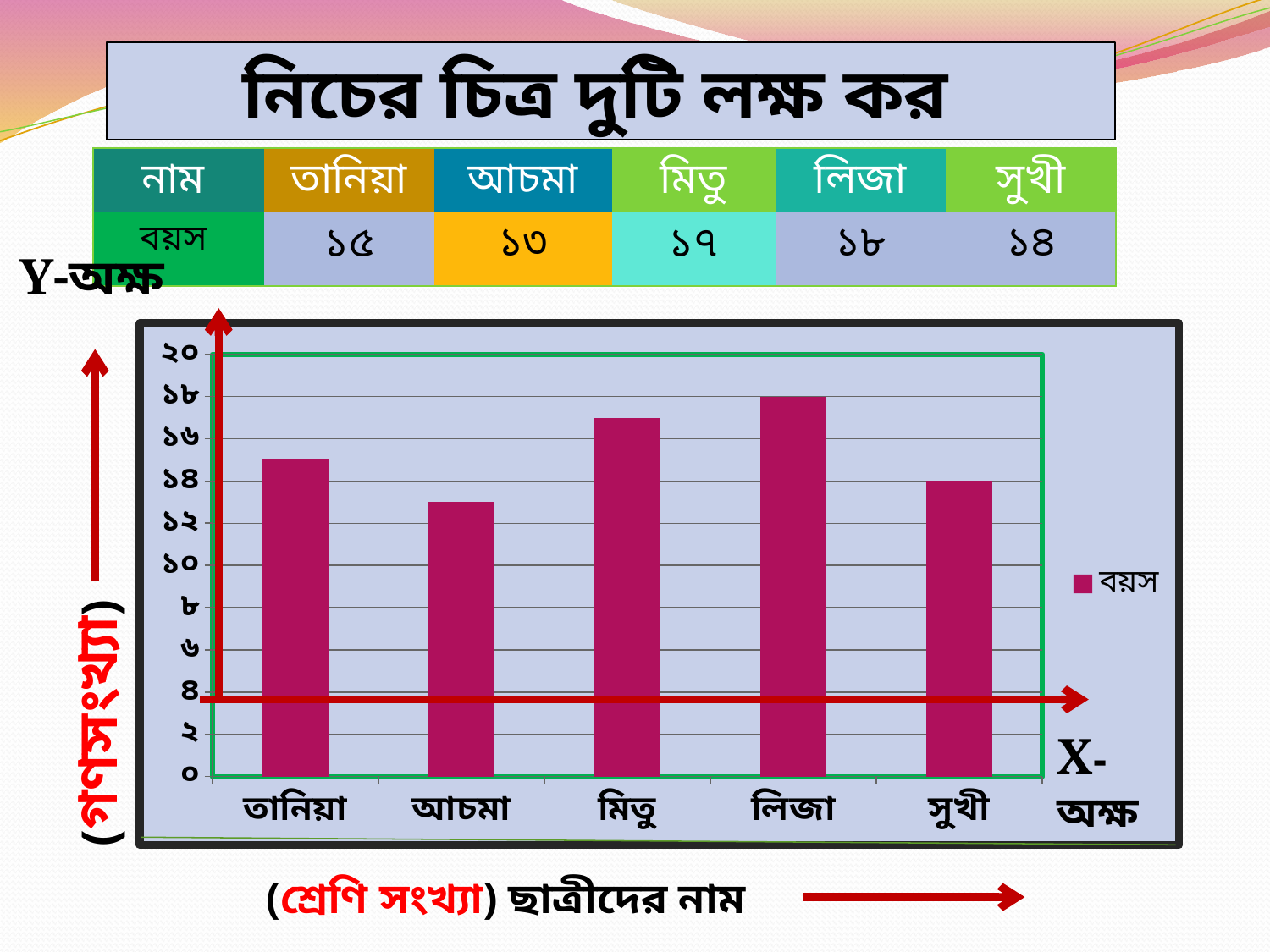
Which is larger, the value for মিতু or the value for সুখী? মিতু How many series does the chart legend list? 1 What type of chart is shown on the slide? bar chart How many bars (students) are plotted on the chart? 5 What is the series name shown in the chart legend? বয়স Which student has the highest value (age) on the chart? লিজা What is the value (age) for তানিয়া? ১৫ Is the value for আচমা greater or less than ১৪? less What is the value (age) for লিজা? ১৮ Is the value for মিতু greater or less than ১৬? greater Which student has the lowest value (age) on the chart? আচমা What is the value (age) for সুখী? ১৪